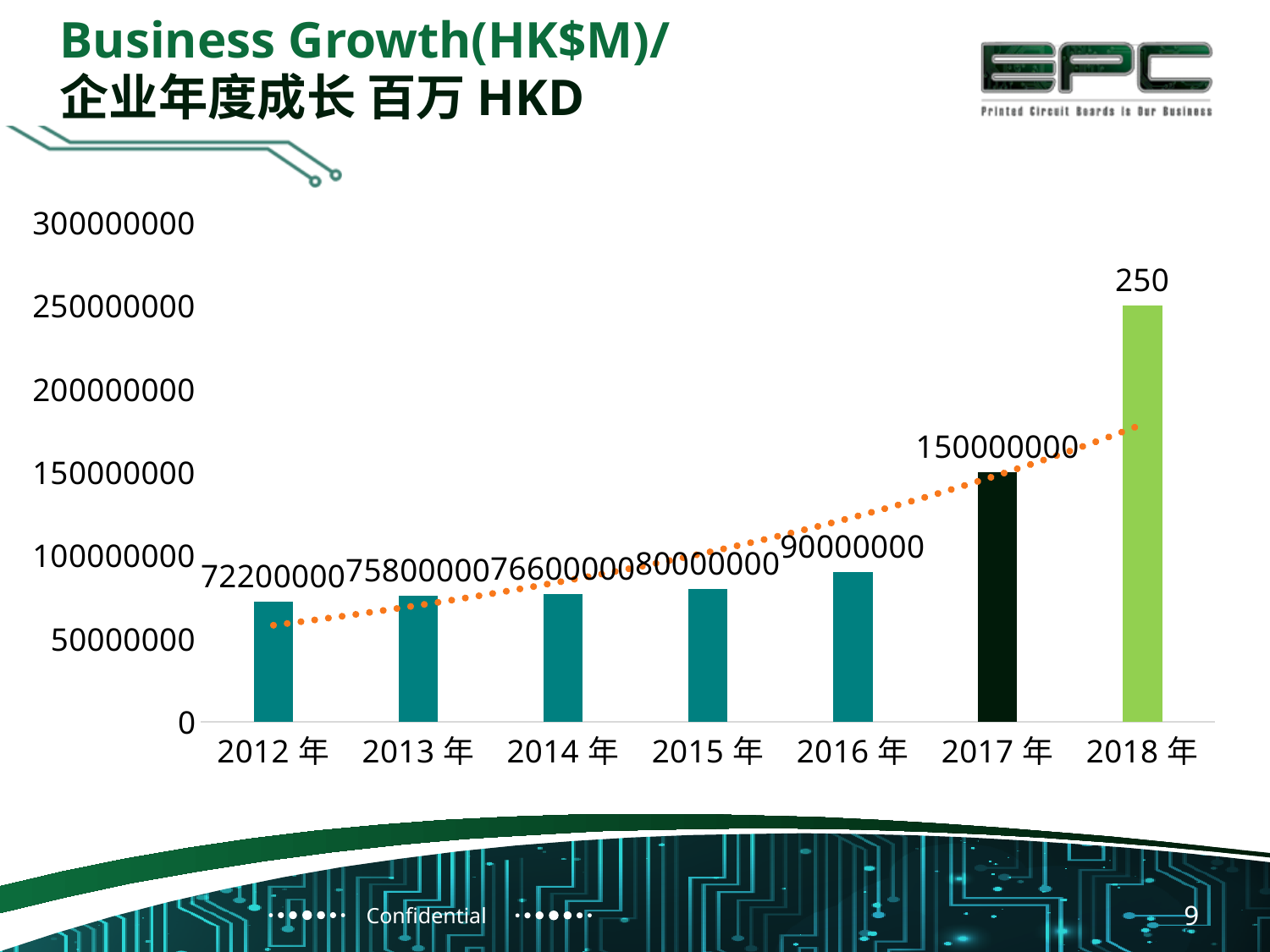
How many years are shown on the x axis? 7 Which year has the lowest bar? 2012 年 What is the difference between the values for 2013 年 and 2012 年? 3600000 Which year has the highest bar? 2018 年 Which is larger, the value for 2014 年 or 2013 年? 2014 年 Is the value for 2016 年 greater or less than 100000000? less What data label is shown above the bar for 2018 年? 250 What is the value for 2016 年? 90000000 What is the difference between the values for 2017 年 and 2016 年? 60000000 What is the value for 2012 年? 72200000 Do the values rise or fall from 2012 年 to 2018 年? rise What is the value for 2017 年? 150000000